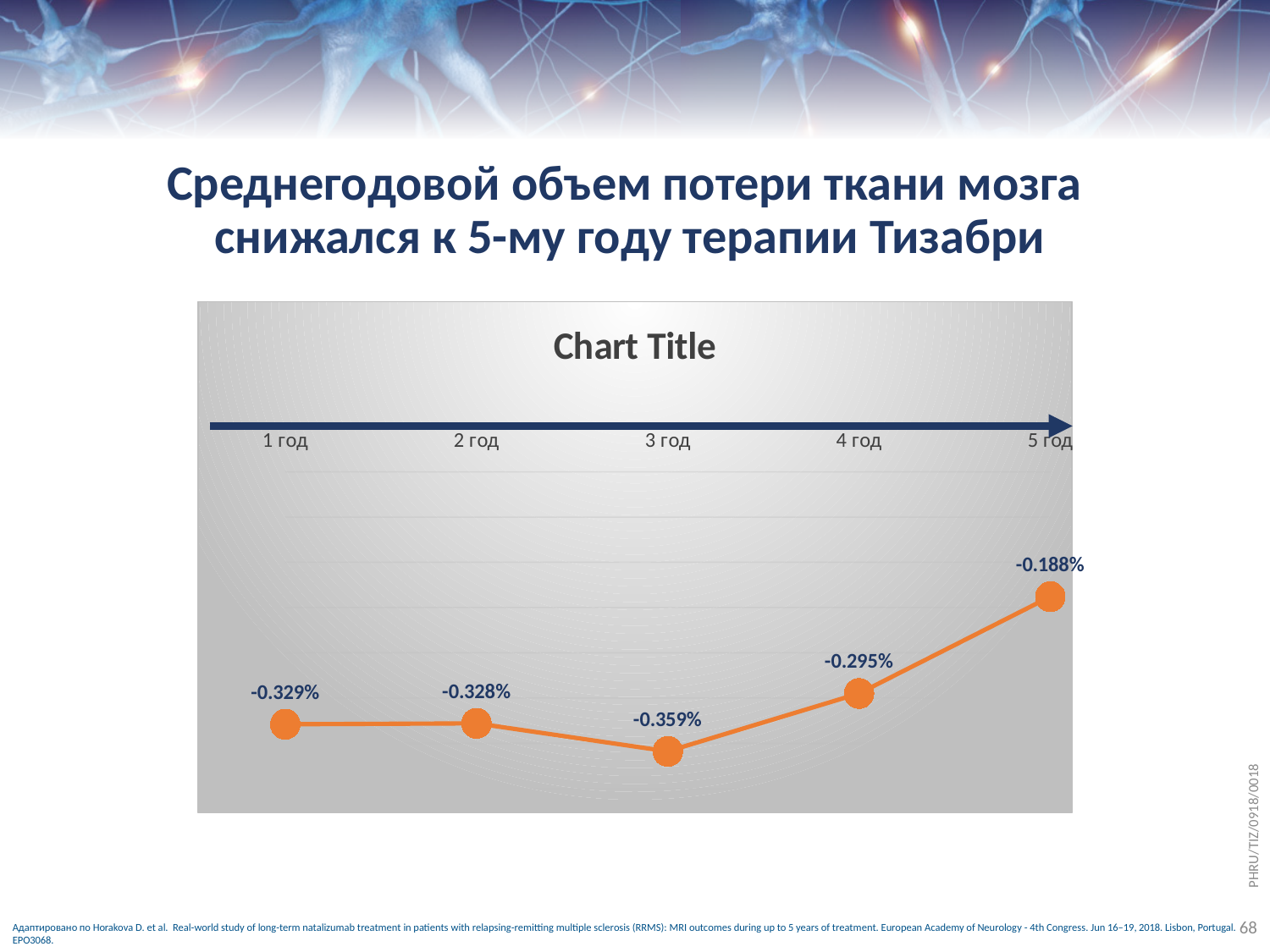
What is the value for 4 год? -0.295% Do the values rise or fall from 3 год to 5 год? Rise Which year has the lowest (most negative) value? 3 год What kind of chart is shown on the slide? Line chart What is the value for 5 год? -0.188% Which year has the highest (least negative) value? 5 год What is the value for 1 год? -0.329% How many data points are plotted on the chart? 5 What is the difference between the values for 5 год and 4 год? 0.107% What is the value for 3 год? -0.359% What is the difference between the values for 3 год and 1 год? 0.030% Which is larger, the value for 4 год or the value for 3 год? 4 год